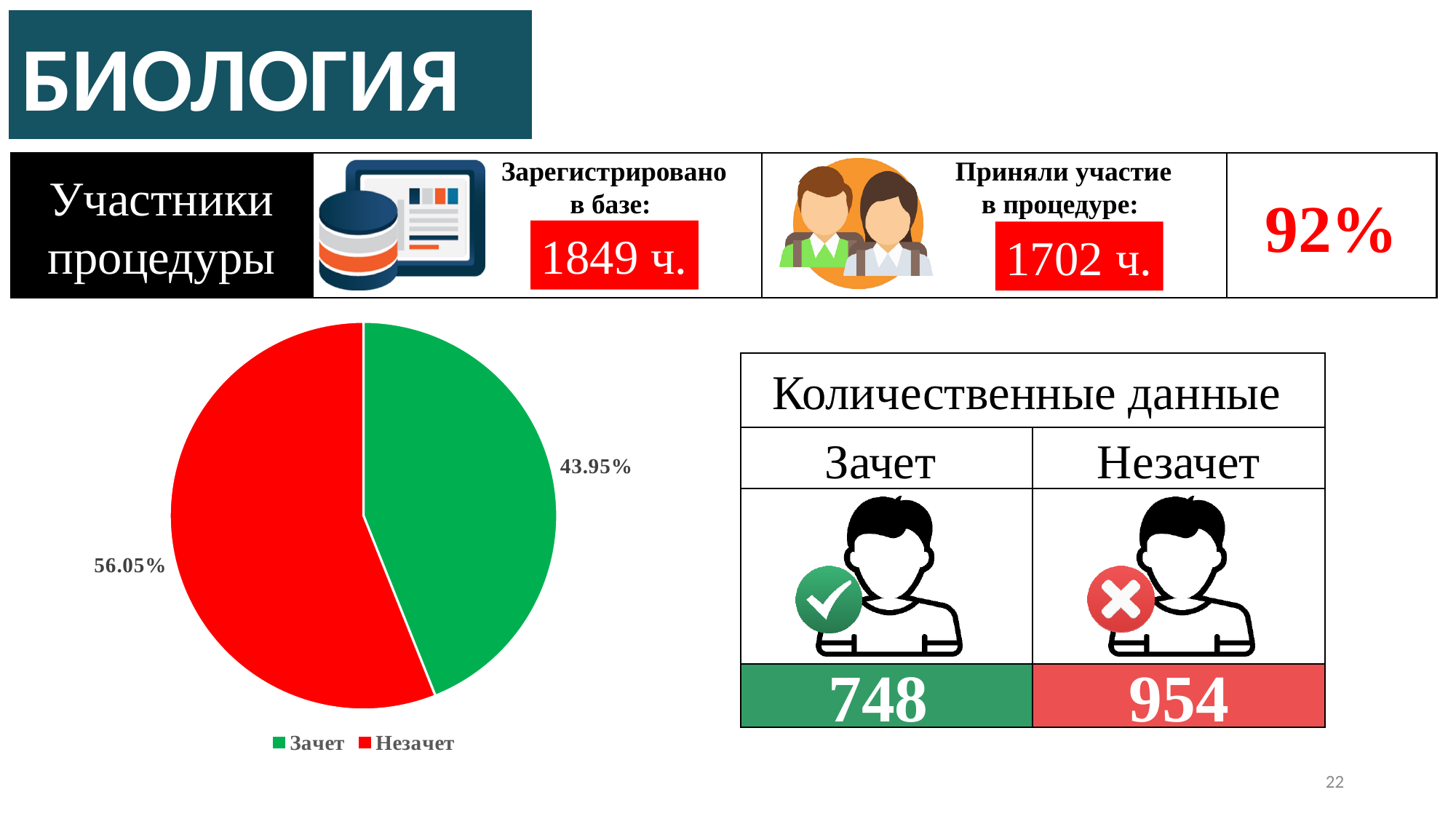
How many slices does the pie chart have? 2 Which slice of the pie chart is the smallest? Зачет Which slice of the pie chart is the largest? Незачет How many entries does the pie chart's legend list? 2 What colour is the Зачет slice in the pie chart? green Which is larger in the pie chart, Зачет or Незачет? Незачет What colour is the Незачет slice in the pie chart? red What is the difference in percentage points between the Незачет and Зачет slices? 12.1 What share of the pie does the Незачет slice represent? 56.05% What share of the pie does the Зачет slice represent? 43.95% What kind of chart is shown on the slide? pie chart